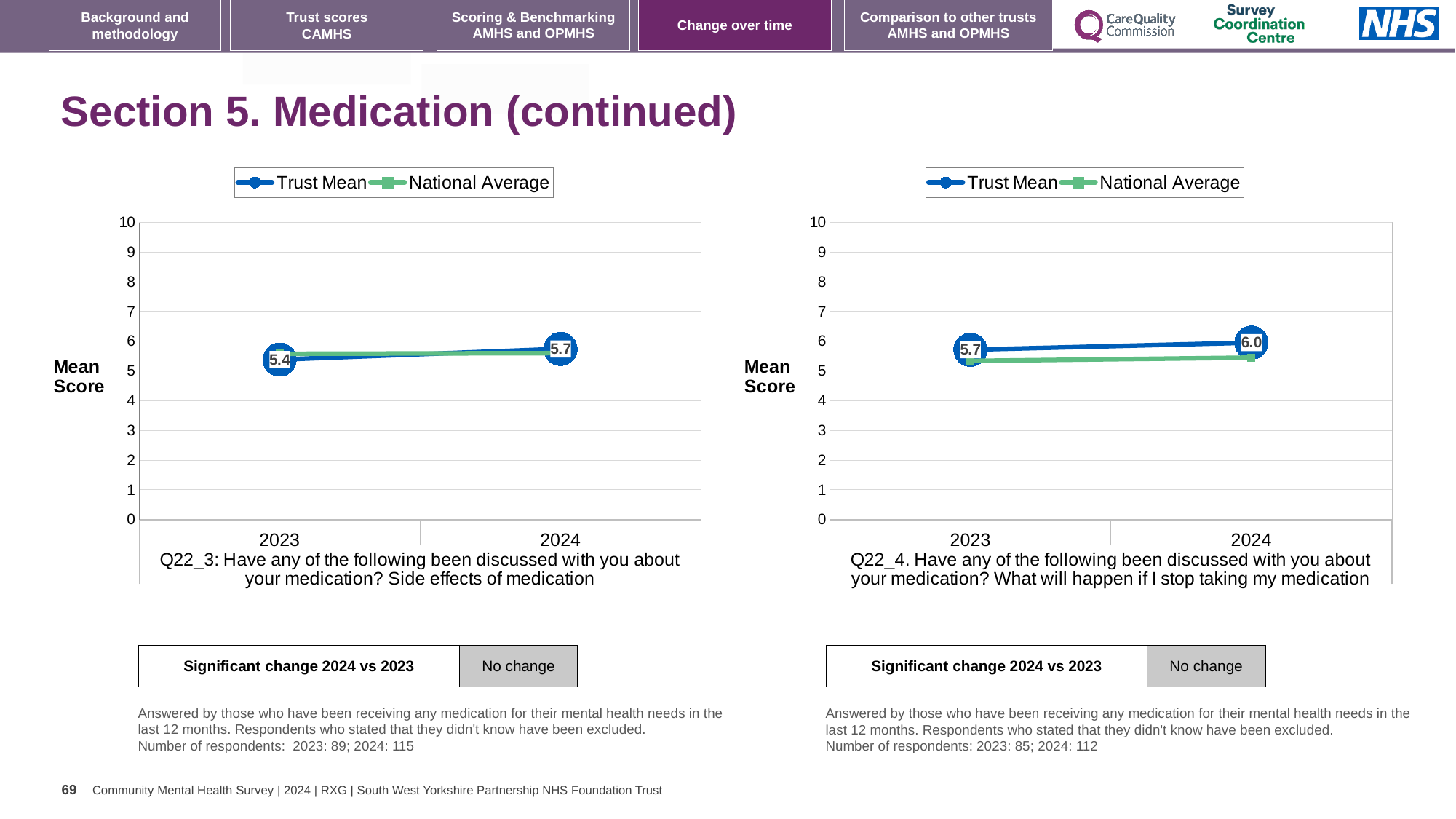
In the Q22_3 chart on the left, what is the Trust Mean for 2024? 5.7 In the Q22_3 chart on the left, what is the Trust Mean for 2023? 5.4 How many years are plotted on the x axis of the Q22_4 chart on the right? 2 In the Q22_4 chart on the right, what is the Trust Mean for 2023? 5.7 In the Q22_3 chart on the left, is the National Average for 2024 greater or less than 5? greater In the Q22_4 chart on the right, does the Trust Mean rise or fall from 2023 to 2024? rise How many series does the legend of the Q22_3 chart on the left list? 2 What kind of chart is the Q22_3 chart on the left? line chart In the Q22_4 chart on the right, what is the Trust Mean for 2024? 6.0 In the Q22_3 chart on the left, by how much did the Trust Mean change from 2023 to 2024? 0.3 In the Q22_4 chart on the right, is the National Average for 2023 greater or less than 6? less In the Q22_4 chart on the right, which is larger in 2024, the Trust Mean or the National Average? Trust Mean